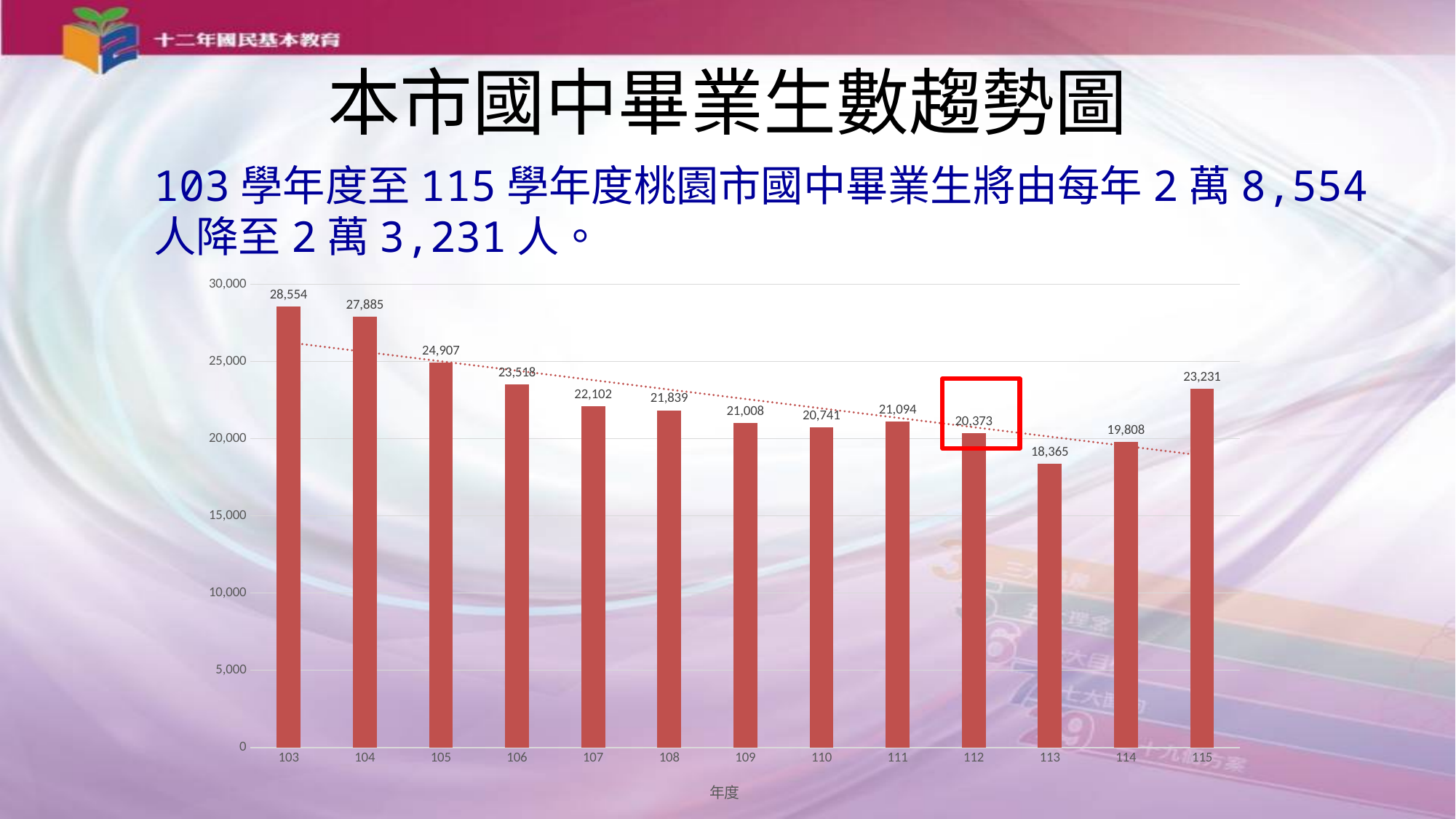
What is the difference between the values for year 103 and year 115? 5,323 What is the difference between the values for year 114 and year 113? 1,443 Which year has the lowest value? 113 What is the value for year 103? 28,554 What kind of chart is this? bar chart What is the value for year 115? 23,231 What is the value for year 112, the bar highlighted with a red box? 20,373 How many years are shown on the x axis? 13 Which year has the highest value? 103 What is the value for year 113? 18,365 Which is larger, the value for year 111 or the value for year 110? 111 What is the x-axis title of the chart? 年度